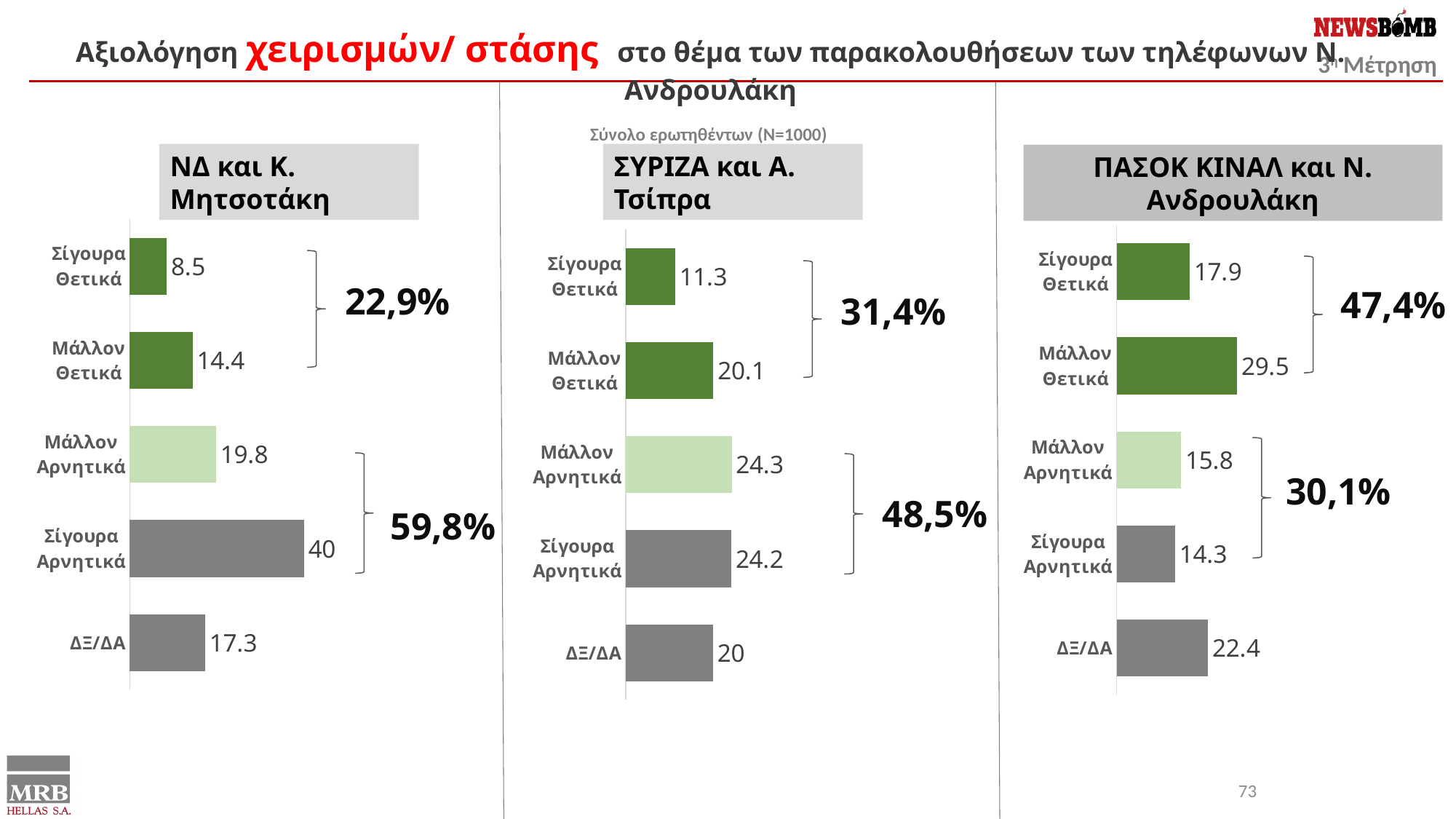
In the chart titled "ΝΔ και Κ. Μητσοτάκη", what is the difference between "Σίγουρα Αρνητικά" and "Μάλλον Αρνητικά"? 20.2 In the chart titled "ΠΑΣΟΚ ΚΙΝΑΛ και Ν. Ανδρουλάκη", what is the value for "ΔΞ/ΔΑ"? 22.4 How many charts are shown on the slide? 3 In the chart titled "ΣΥΡΙΖΑ και Α. Τσίπρα", which category has the lowest value? Σίγουρα Θετικά In the chart titled "ΠΑΣΟΚ ΚΙΝΑΛ και Ν. Ανδρουλάκη", which is larger, "Σίγουρα Θετικά" or "Σίγουρα Αρνητικά"? Σίγουρα Θετικά In the chart titled "ΝΔ και Κ. Μητσοτάκη", what is the value for "Σίγουρα Αρνητικά"? 40 In the chart titled "ΠΑΣΟΚ ΚΙΝΑΛ και Ν. Ανδρουλάκη", which category has the highest value? Μάλλον Θετικά How many categories does the chart titled "ΝΔ και Κ. Μητσοτάκη" show? 5 In the chart titled "ΣΥΡΙΖΑ και Α. Τσίπρα", what is the combined share shown for the two negative categories (Μάλλον Αρνητικά and Σίγουρα Αρνητικά)? 48,5% What kind of chart is the chart titled "ΣΥΡΙΖΑ και Α. Τσίπρα"? Bar chart In the chart titled "ΣΥΡΙΖΑ και Α. Τσίπρα", what is the value for "Μάλλον Θετικά"? 20.1 In the chart titled "ΝΔ και Κ. Μητσοτάκη", which category has the lowest value? Σίγουρα Θετικά